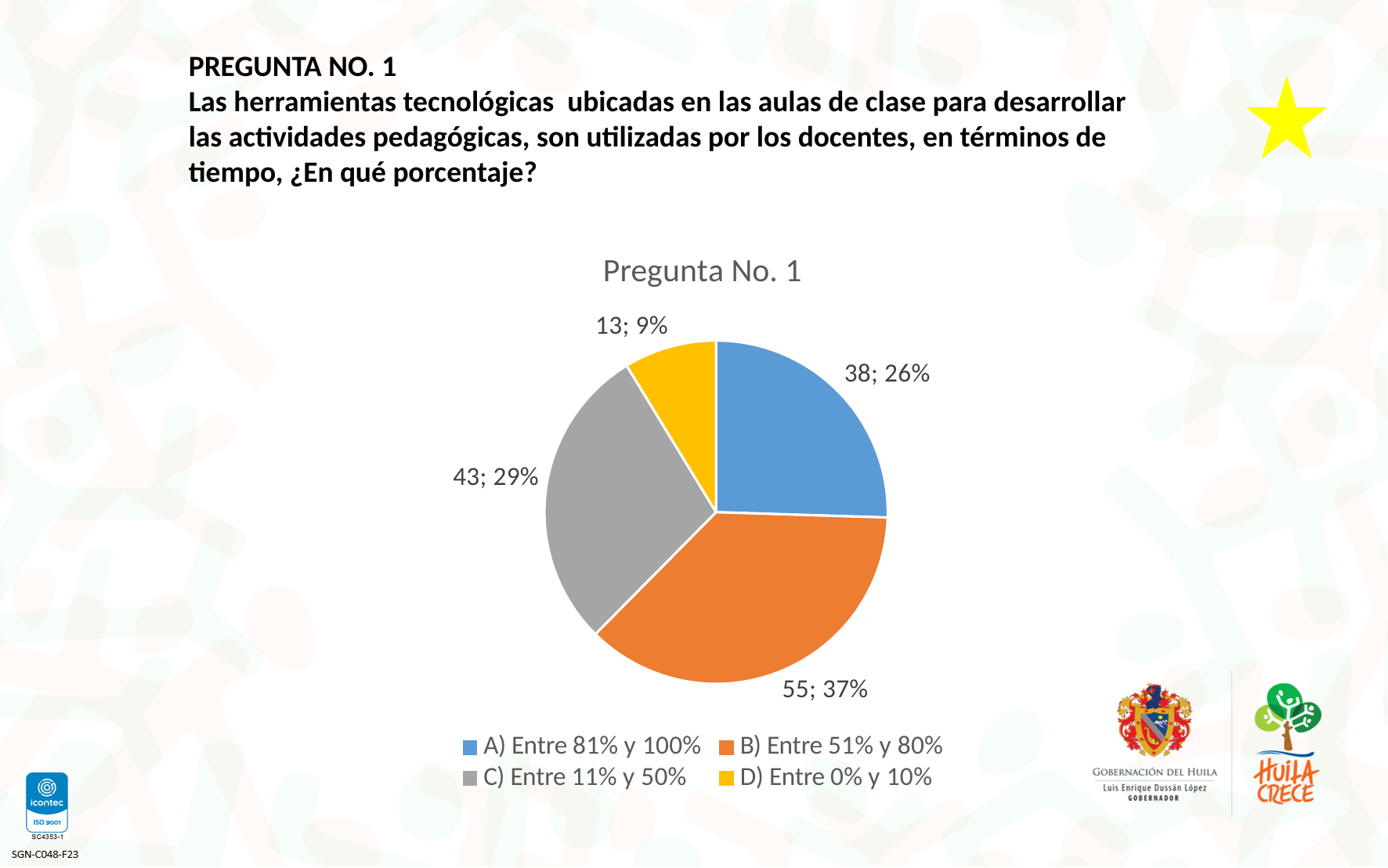
What colour is the slice for "D) Entre 0% y 10%"? yellow What is the count for "D) Entre 0% y 10%"? 13 Which category has the smallest slice? D) Entre 0% y 10% Which is larger, the count for "C) Entre 11% y 50%" or for "A) Entre 81% y 100%"? C) Entre 11% y 50% What is the chart's title? Pregunta No. 1 What percentage share does "A) Entre 81% y 100%" have? 26% What is the difference in count between "B) Entre 51% y 80%" and "A) Entre 81% y 100%"? 17 Which category has the largest slice? B) Entre 51% y 80% What percentage share does "C) Entre 11% y 50%" have? 29% What is the count for "B) Entre 51% y 80%"? 55 How many slices does the pie chart have? 4 What kind of chart is shown on the slide? pie chart